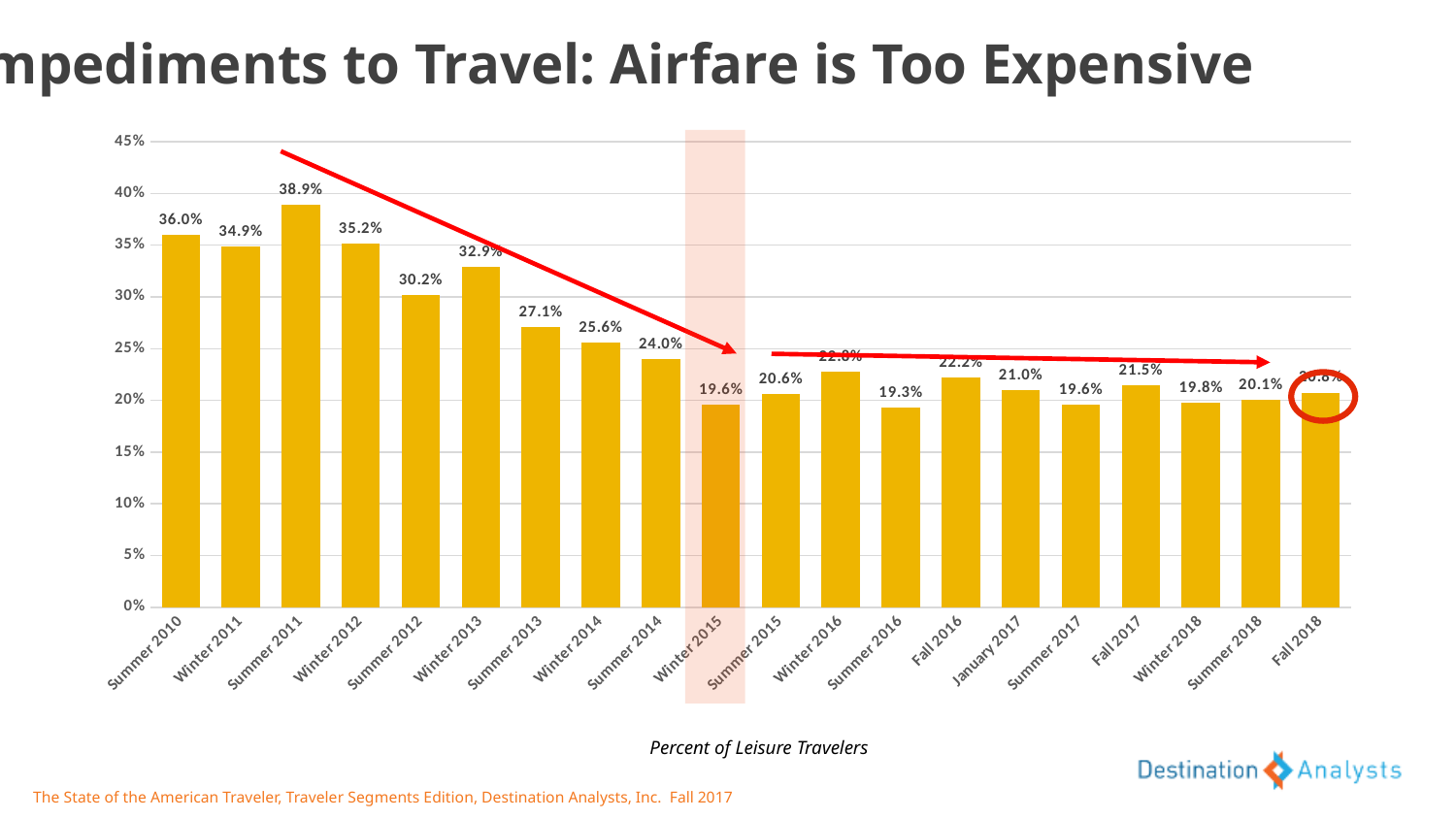
Which period has the highest value? Summer 2011 What is the value for Summer 2010? 36.0% Which is larger, the value for Winter 2013 or the value for Summer 2012? Winter 2013 How many periods are shown on the x axis? 20 What is the difference between the values for Summer 2010 and Summer 2014? 12.0 percentage points What is the value for Fall 2017? 21.5% What kind of chart is shown on the slide? bar chart Do the values generally rise or fall from Summer 2010 to Fall 2018? fall Is the value for Summer 2013 greater or less than 25%? greater Which period has the lowest value? Summer 2016 Which period's bar is highlighted with a shaded background? Winter 2015 What is the value for Winter 2015? 19.6%